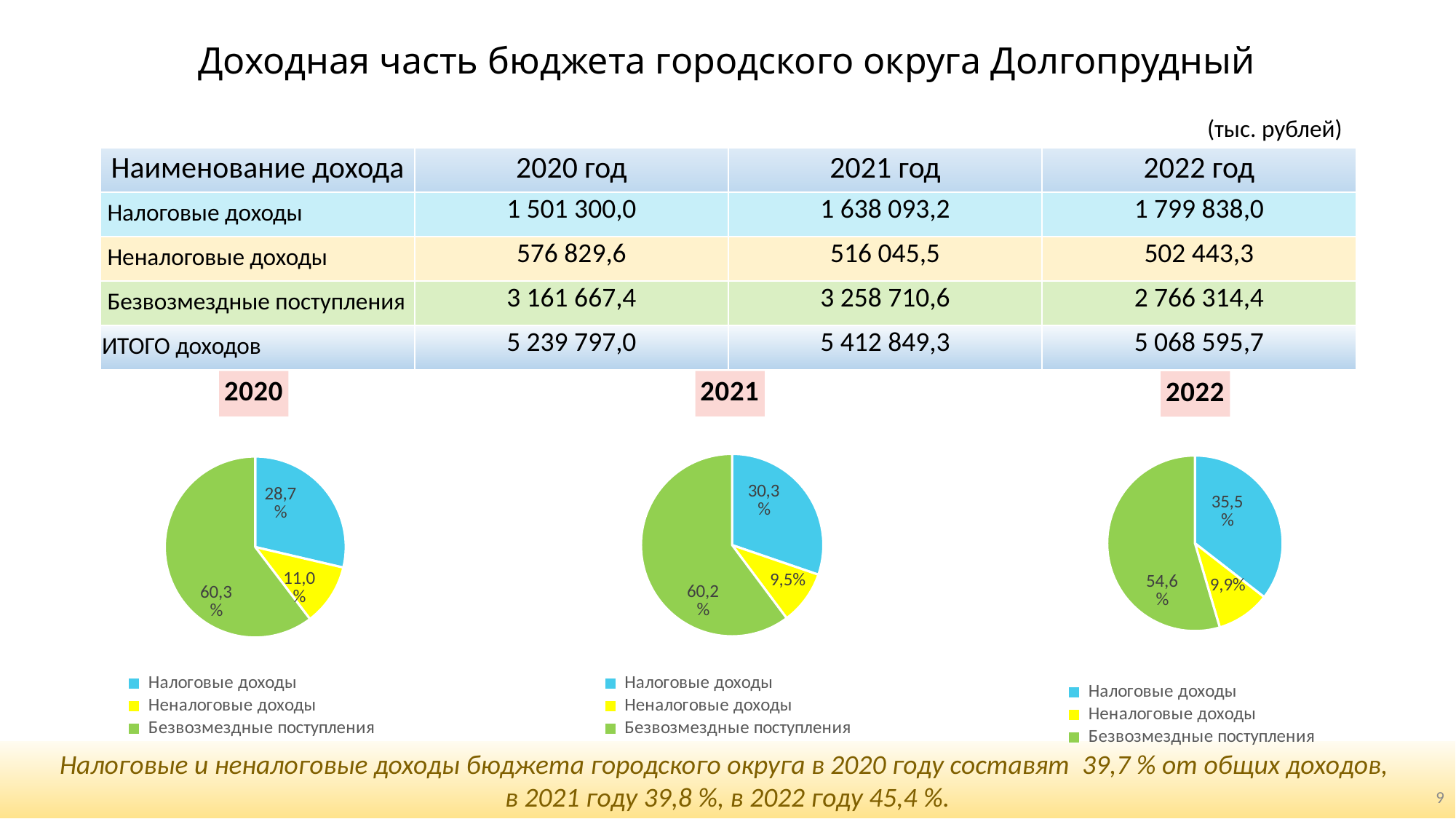
How many slices does the 2021 pie chart have? 3 In the 2021 pie chart, what share is shown for Неналоговые доходы? 9,5% In the 2020 pie chart, which category has the smallest slice? Неналоговые доходы In the 2022 pie chart, which category has the largest slice? Безвозмездные поступления Which is larger in the 2021 pie chart: the share of Налоговые доходы or the share of Неналоговые доходы? Налоговые доходы In the 2020 pie chart, what share is shown for Налоговые доходы? 28,7% How many entries does the legend of the 2020 pie chart list? 3 In the 2022 pie chart, what share is shown for Безвозмездные поступления? 54,6% In the 2022 pie chart, what colour is the slice for Неналоговые доходы? Yellow In the 2022 pie chart, what is the difference between the shares of Налоговые доходы and Неналоговые доходы? 25,6% What type of chart is used for the 2020, 2021 and 2022 charts on the slide? Pie chart Across the 2020, 2021 and 2022 pie charts, does the share of Налоговые доходы rise or fall from year to year? Rises